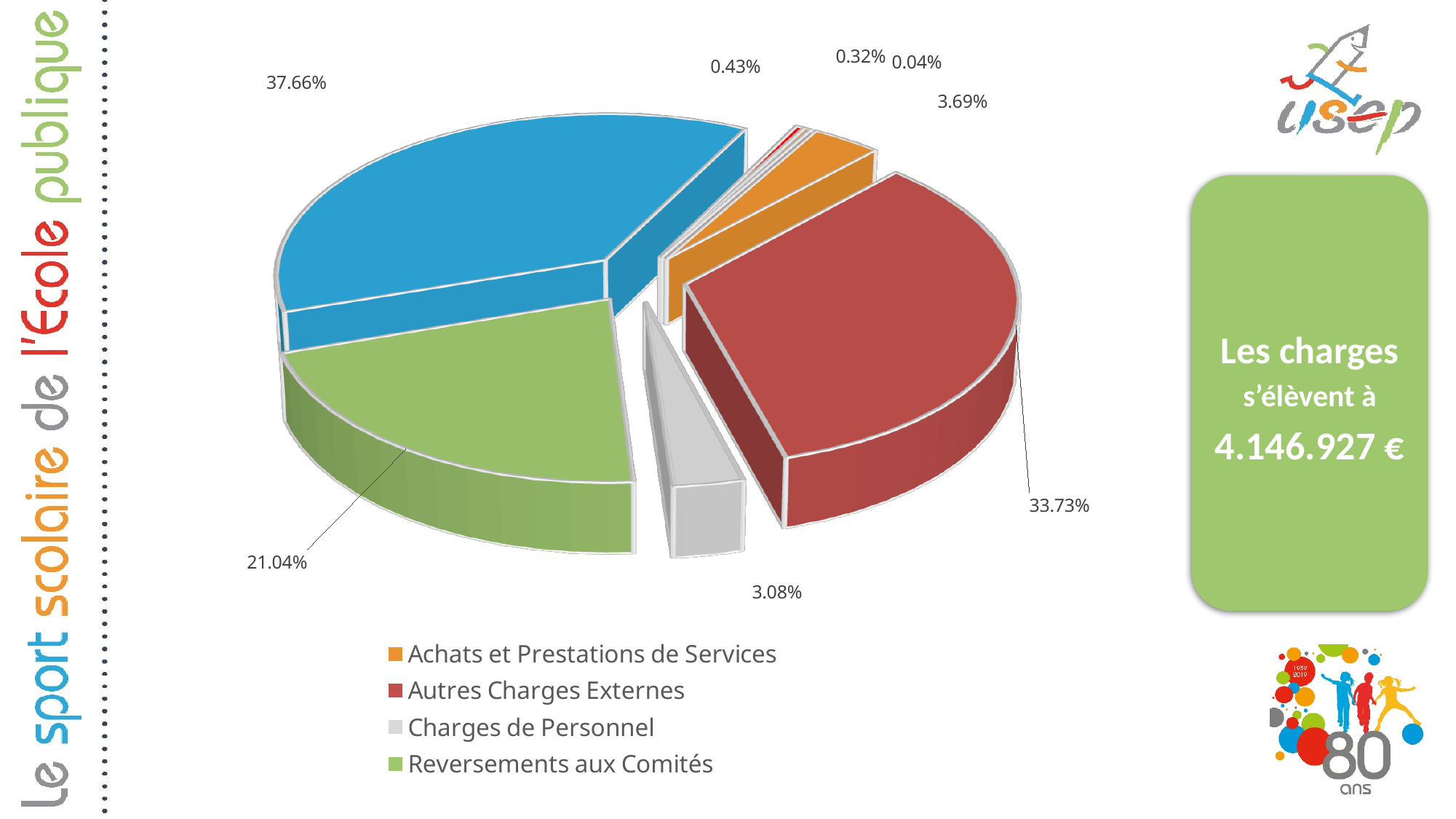
What percentage does the pie chart show for Reversements aux Comités? 21.04% How many entries does the legend of the pie chart list? 4 What percentage does the pie chart show for Achats et Prestations de Services? 3.69% By how many percentage points does Autres Charges Externes exceed Reversements aux Comités? 12.69 What is the largest percentage labelled on the pie chart? 37.66% What is the smallest percentage labelled on the pie chart? 0.04% What percentage does the pie chart show for Charges de Personnel? 3.08% What colour represents Autres Charges Externes in the pie chart? Red Which is larger in the pie chart: Autres Charges Externes or Reversements aux Comités? Autres Charges Externes How many percentage labels are shown on the pie chart? 8 What percentage does the pie chart show for Autres Charges Externes? 33.73% What type of chart is shown on the slide? Pie chart